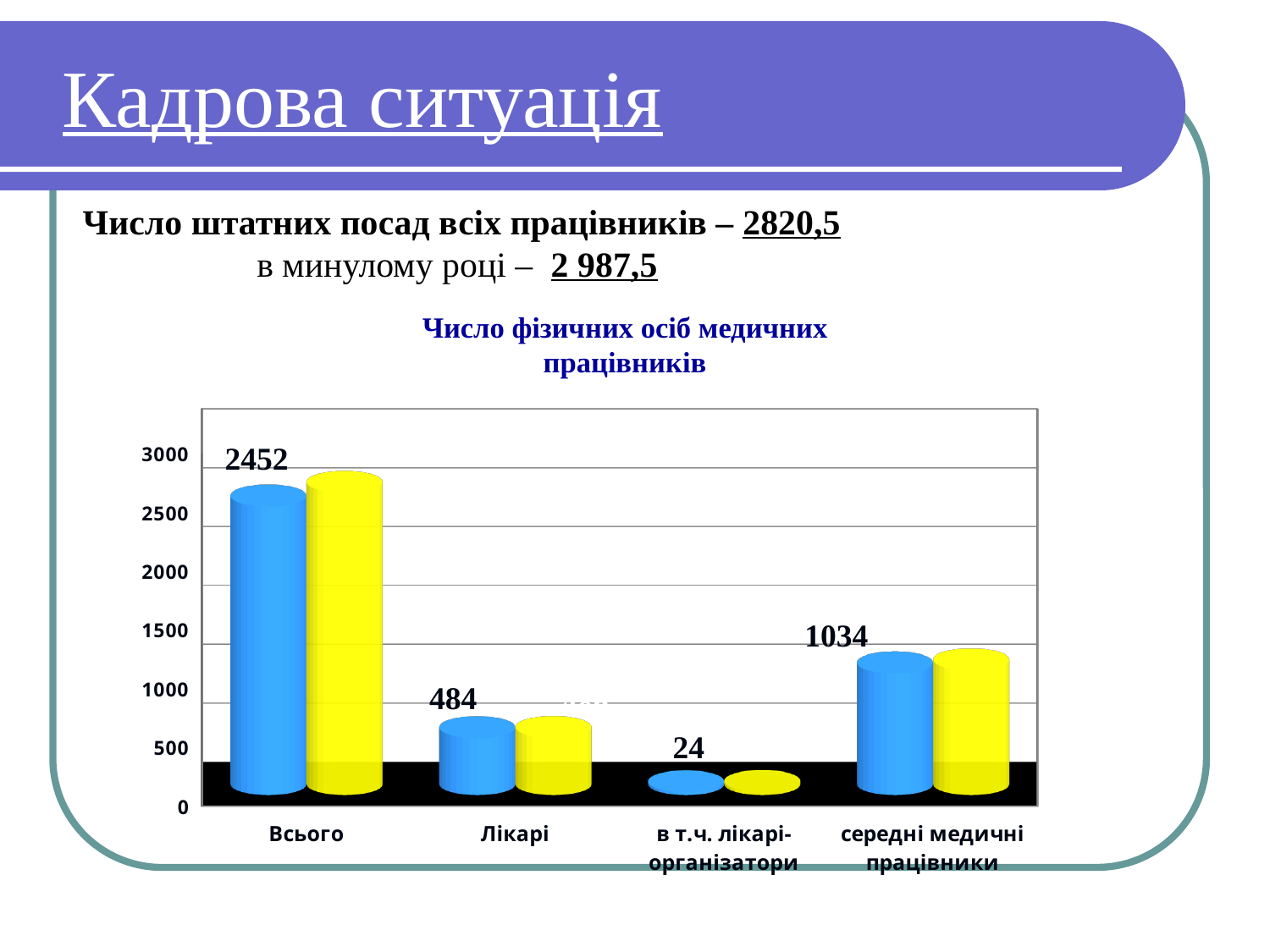
What is the title of the chart? Число фізичних осіб медичних працівників Which category has the lowest blue bar? в т.ч. лікарі-організатори What is the value shown on the blue bar for в т.ч. лікарі-організатори? 24 What is the value shown on the blue bar for середні медичні працівники? 1034 What is the difference between the blue bar values for Всього and середні медичні працівники? 1418 Which has a larger blue bar value, Лікарі or середні медичні працівники? середні медичні працівники What is the difference between the blue bar values for Лікарі and в т.ч. лікарі-організатори? 460 How many categories are shown on the x axis of the chart? 4 Which category has the highest blue bar? Всього What is the value shown on the blue bar for Лікарі? 484 What is the value shown on the blue bar for Всього? 2452 Is the yellow bar for Всього greater or less than 2500? greater